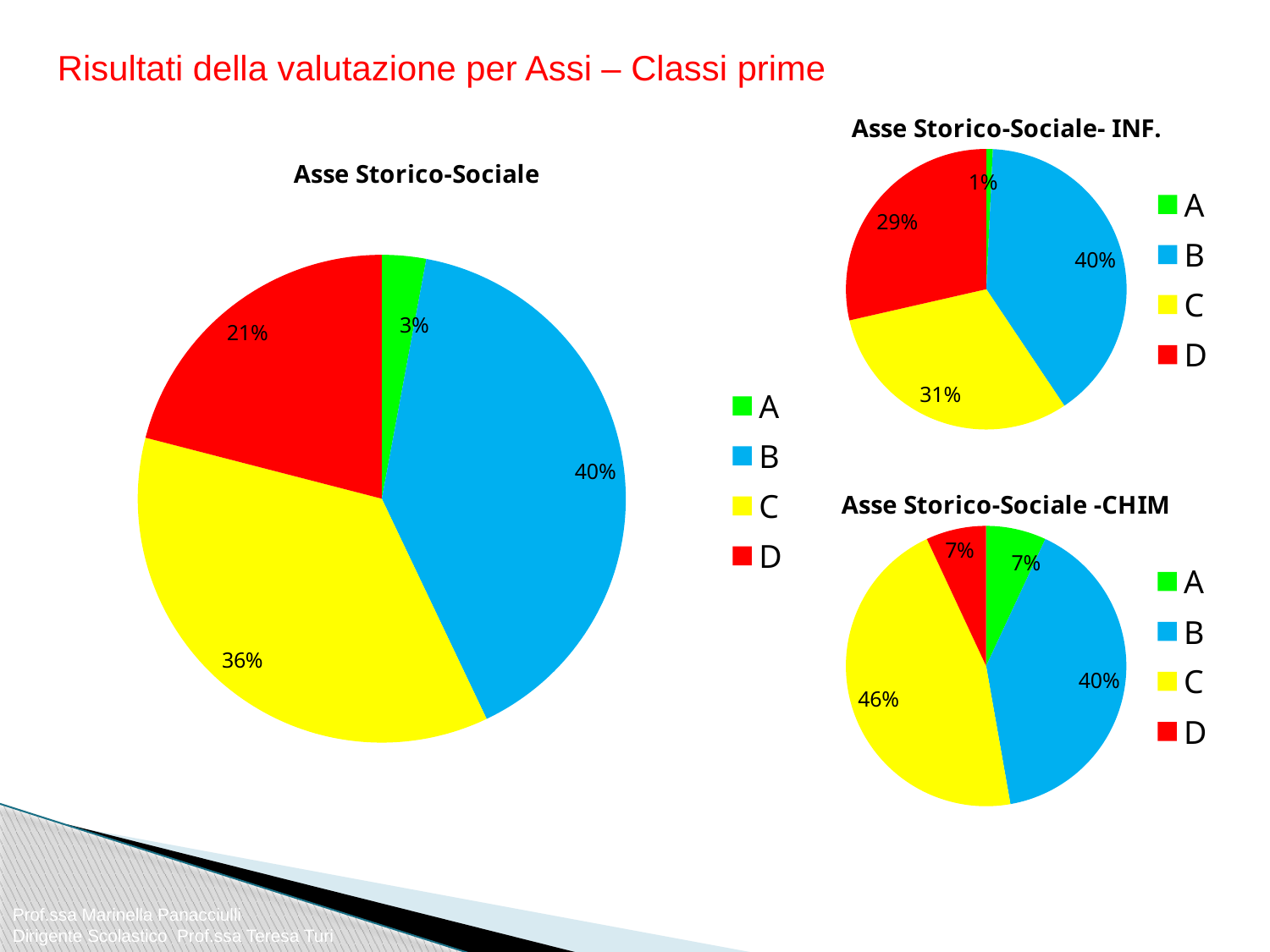
In the 'Asse Storico-Sociale -CHIM' chart, what is the difference between the shares of C and B? 6% In the 'Asse Storico-Sociale -CHIM' chart, which category has the largest share? C What type of chart is 'Asse Storico-Sociale -CHIM'? Pie chart In the 'Asse Storico-Sociale- INF.' chart, what share does category D have? 29% In the 'Asse Storico-Sociale' chart, what share does category C have? 36% In the 'Asse Storico-Sociale- INF.' chart, which category has the smallest share? A How many categories does the legend of the 'Asse Storico-Sociale' chart list? 4 In the 'Asse Storico-Sociale -CHIM' chart, what share does category C have? 46% In the 'Asse Storico-Sociale' chart, which category has the largest share? B In the 'Asse Storico-Sociale' chart, which category has the smallest share? A In the 'Asse Storico-Sociale' chart, what is the difference between the shares of B and D? 19% In the 'Asse Storico-Sociale- INF.' chart, which is larger, the share of C or the share of D? C